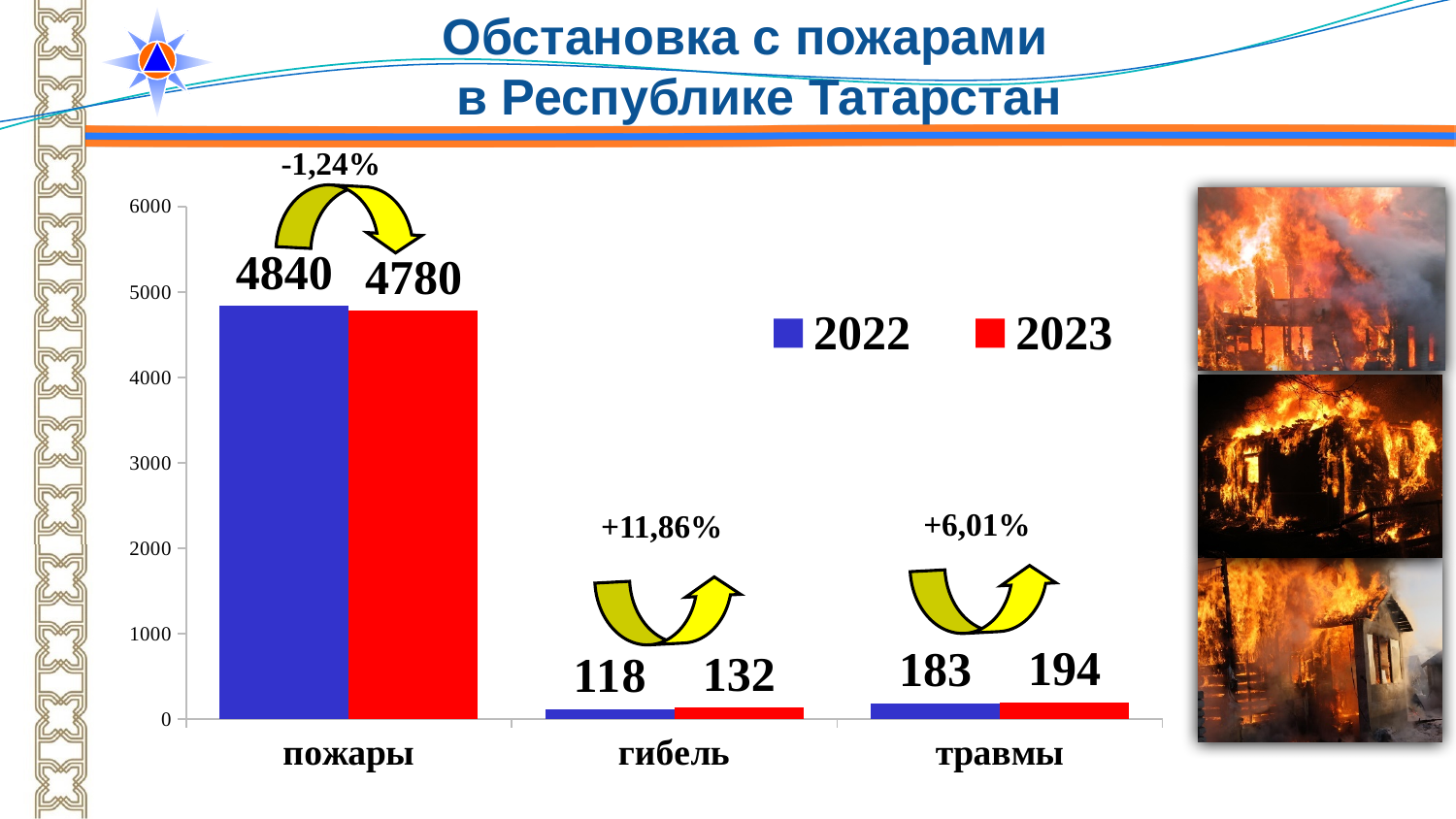
Which category has the lowest value for 2022? гибель How many series does the legend list? 2 What is the value for пожары in 2023? 4780 What is the value for пожары in 2022? 4840 Which category has the highest values in the chart? пожары What is the difference between the 2023 and 2022 values for гибель? 14 What percentage change is shown above the гибель bars? +11,86% What is the difference between the 2022 and 2023 values for пожары? 60 What is the value for травмы in 2022? 183 What is the value for гибель in 2023? 132 Which is larger for травмы: the 2022 value or the 2023 value? 2023 How many categories are shown on the x axis? 3